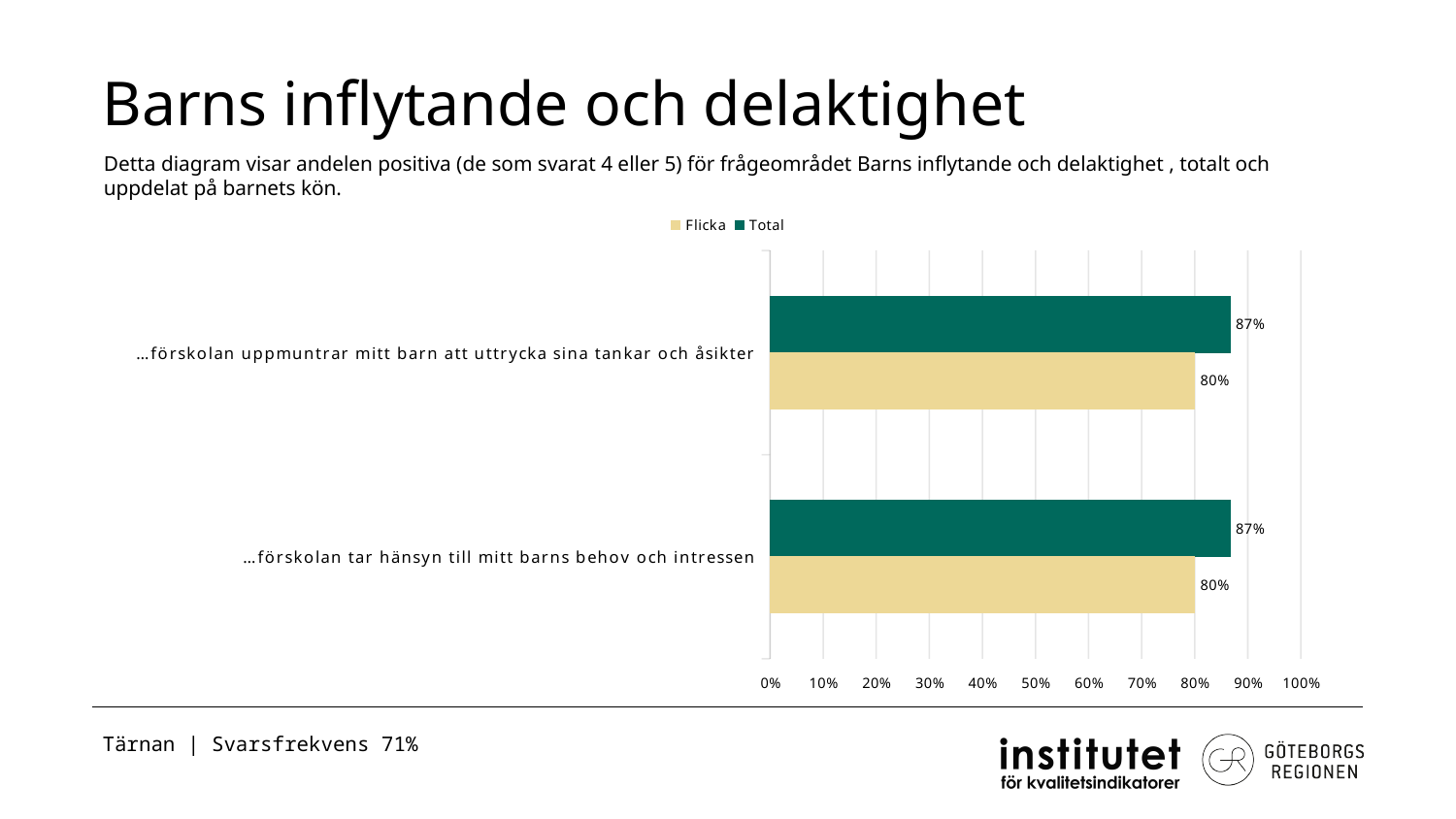
What is the Total value for "…förskolan uppmuntrar mitt barn att uttrycka sina tankar och åsikter"? 87% What is the title of the slide? Barns inflytande och delaktighet What is the Total value for "…förskolan tar hänsyn till mitt barns behov och intressen"? 87% What is the Flicka value for "…förskolan uppmuntrar mitt barn att uttrycka sina tankar och åsikter"? 80% What kind of chart is shown on the slide? Bar chart How many categories are shown on the chart? 2 How many series does the legend list? 2 What is the Flicka value for "…förskolan tar hänsyn till mitt barns behov och intressen"? 80% Which series is shown in dark green in the legend? Total Is the Flicka value for "…förskolan tar hänsyn till mitt barns behov och intressen" greater or less than 90%? less What is the difference between the Total and Flicka values for "…förskolan tar hänsyn till mitt barns behov och intressen"? 7 percentage points For "…förskolan uppmuntrar mitt barn att uttrycka sina tankar och åsikter", which is larger, the Flicka value or the Total value? Total